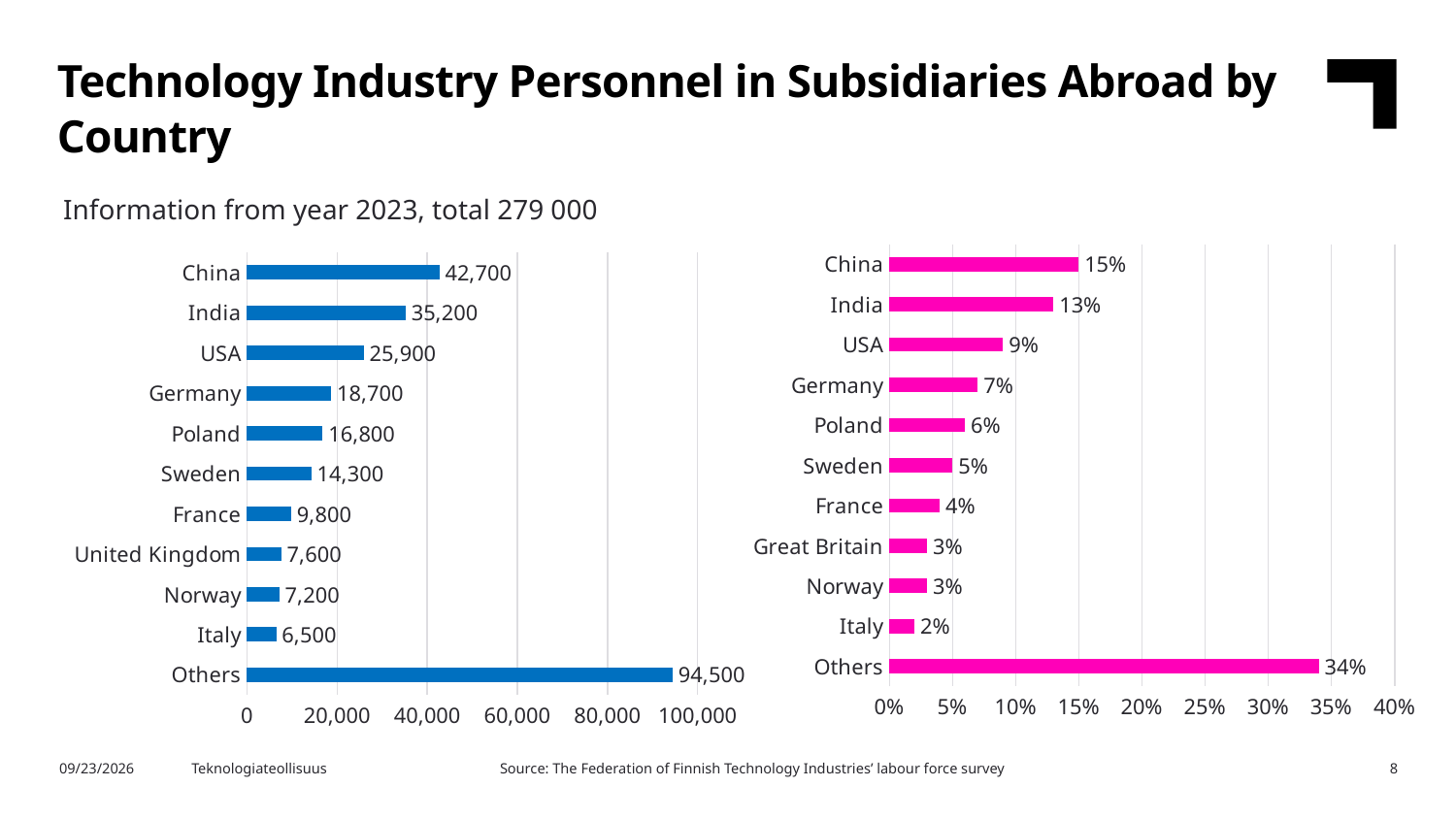
In the right chart, what is the percentage for Others? 34% In the left chart, what is the difference between the values for China and India? 7,500 In the left chart, which category has the lowest value? Italy In the right chart, what is the difference between the percentages for USA and Germany? 2% In the left chart, which named country (excluding Others) has the highest value? China In the right chart, what is the percentage for India? 13% How many categories are shown in the left chart? 11 What colour are the bars in the right chart? pink In the left chart, what is the value for China? 42,700 What kind of chart is the right chart? bar chart In the left chart, is the value for Others greater or less than 80,000? greater In the left chart, which is larger, the value for Poland or the value for Sweden? Poland